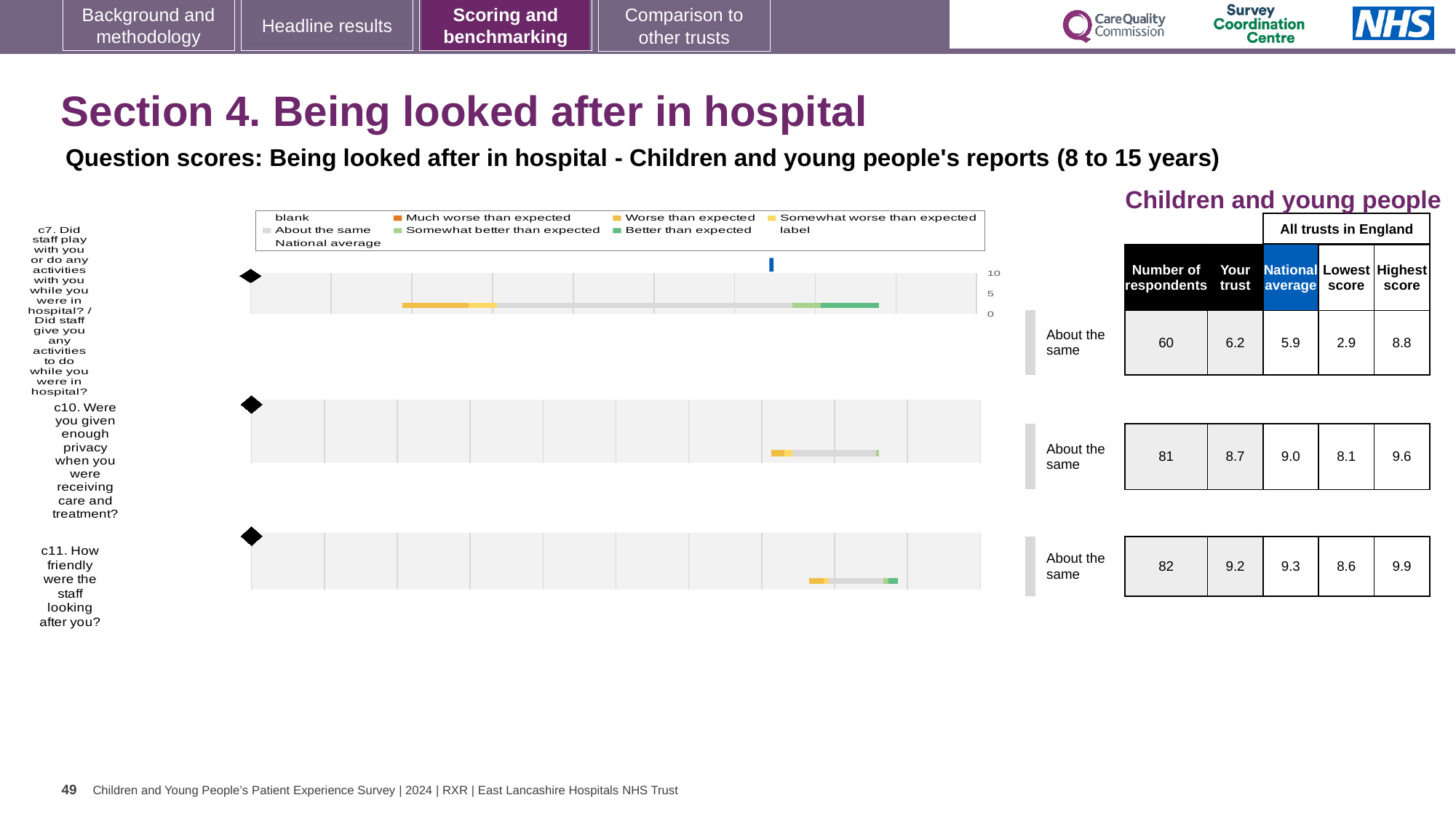
What benchmark category is shown for question c11? About the same Which of the three questions (c7, c10, c11) has the highest 'Your trust' score? c11 What is the national average score for question c10 (Were you given enough privacy when you were receiving care and treatment?)? 9.0 What is the difference between the national average and the 'Your trust' score for question c10? 0.3 What is the lowest score across all trusts in England for question c11? 8.6 What is the 'Your trust' score for question c7 (Did staff play with you or do any activities with you while you were in hospital?)? 6.2 How many questions are plotted on this slide? 3 Is the 'Your trust' score for question c7 higher or lower than the national average for that question? higher What kind of chart is used to show the question scores on this slide? Bar chart Which of the three questions (c7, c10, c11) has the lowest national average score? c7 How many respondents answered question c11 (How friendly were the staff looking after you?)? 82 What is the highest score across all trusts in England for question c7? 8.8